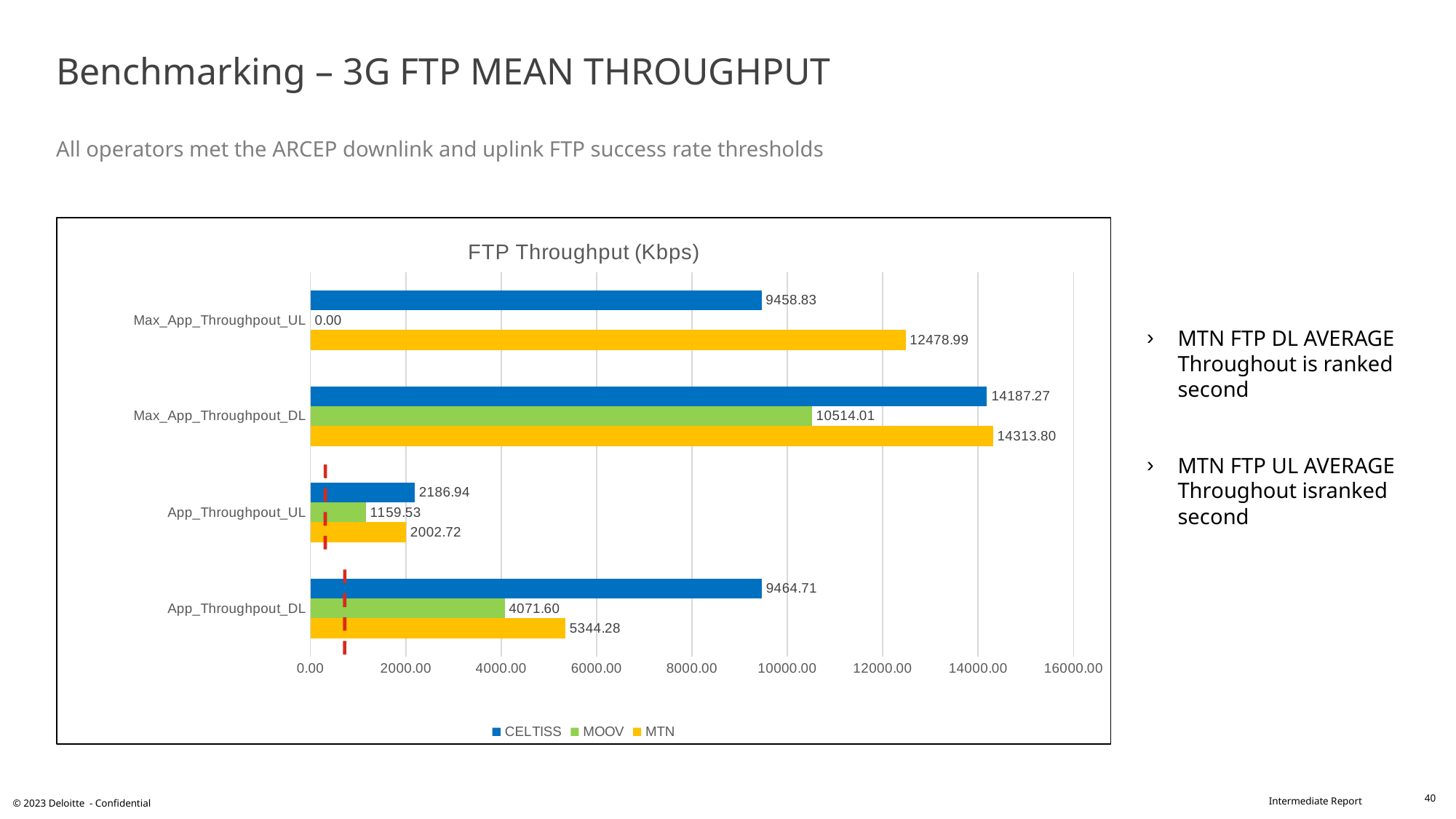
How many series does the legend list? 3 What is the MTN value for Max_App_Throughpout_UL? 12478.99 What is the difference between the MTN and MOOV values for App_Throughpout_DL? 1272.68 What kind of chart is shown on the slide? Bar chart What is the MOOV value for App_Throughpout_DL? 4071.60 Which operator has the lowest value for Max_App_Throughpout_DL? MOOV How many categories are shown on the y axis of the chart? 4 Which operator has the highest value for App_Throughpout_DL? CELTISS What is the MOOV value for Max_App_Throughpout_UL? 0.00 Which is larger for App_Throughpout_UL, the CELTISS value or the MTN value? CELTISS What is the CELTISS value for App_Throughpout_UL? 2186.94 What is the title of the chart? FTP Throughput (Kbps)